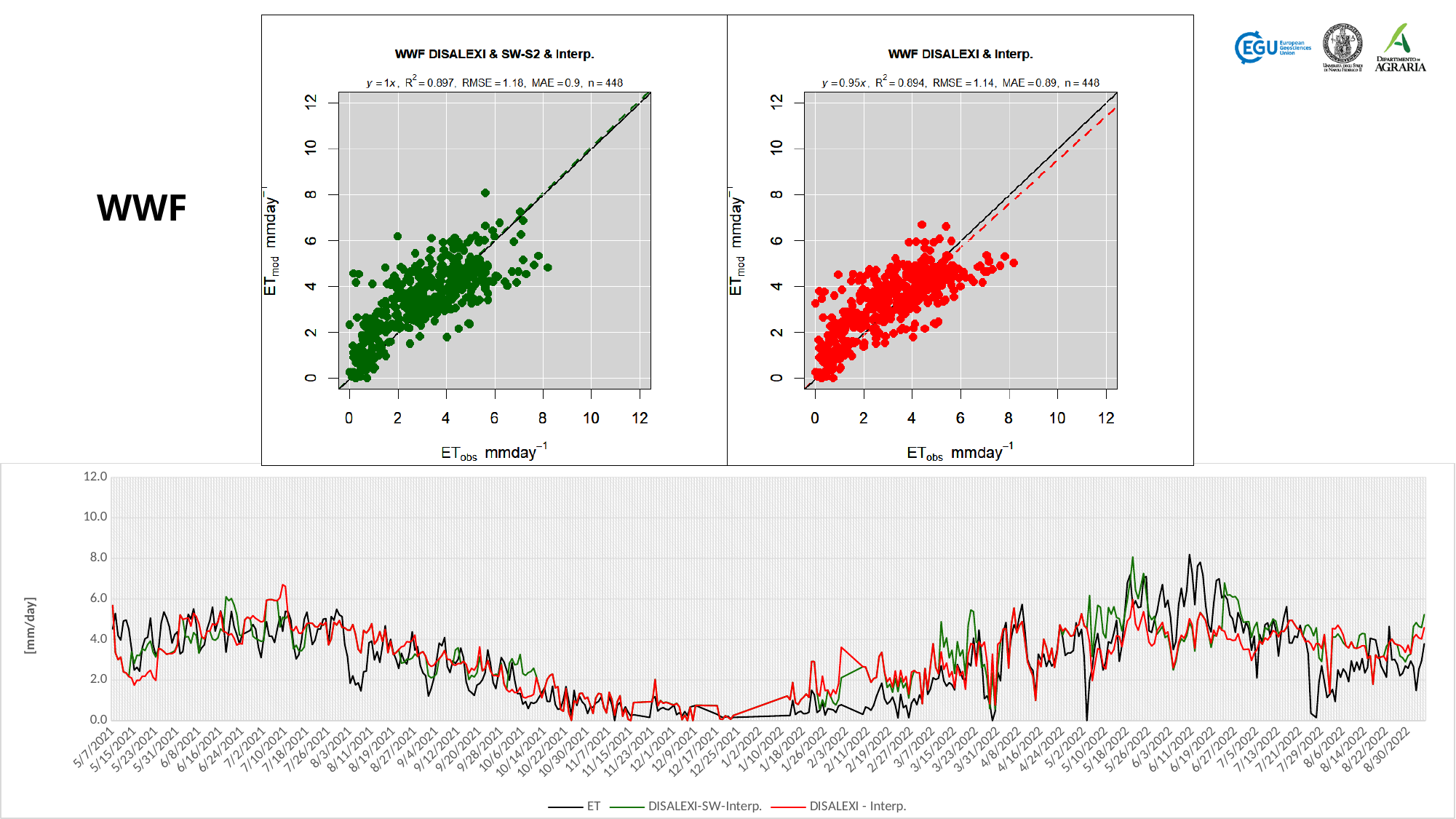
In the top-left chart 'WWF DISALEXI & SW-S2 & Interp.', what is the MAE value printed above the plot? 0.9 In the top-right chart 'WWF DISALEXI & Interp.', what is the number of points n stated above the plot? 448 What type of chart is the bottom chart on the slide? line chart What type of chart is the top-left chart titled 'WWF DISALEXI & SW-S2 & Interp.'? scatter plot What is the difference between the R² values of the top-left chart (0.897) and the top-right chart (0.894)? 0.003 In the bottom line chart, is the ET value around 12/17/2021 greater or less than 2.0? less In the top-left chart 'WWF DISALEXI & SW-S2 & Interp.', what is the R² value printed above the plot? 0.897 In the top-right chart 'WWF DISALEXI & Interp.', what is the RMSE value printed above the plot? 1.14 How many series does the legend of the bottom line chart list? 3 Which of the two top scatter plots has the higher RMSE, 'WWF DISALEXI & SW-S2 & Interp.' or 'WWF DISALEXI & Interp.'? WWF DISALEXI & SW-S2 & Interp. In the bottom line chart, do the values generally rise or fall from 7/2/2021 to 12/9/2021? fall What is the y-axis label of the bottom line chart? [mm/day]